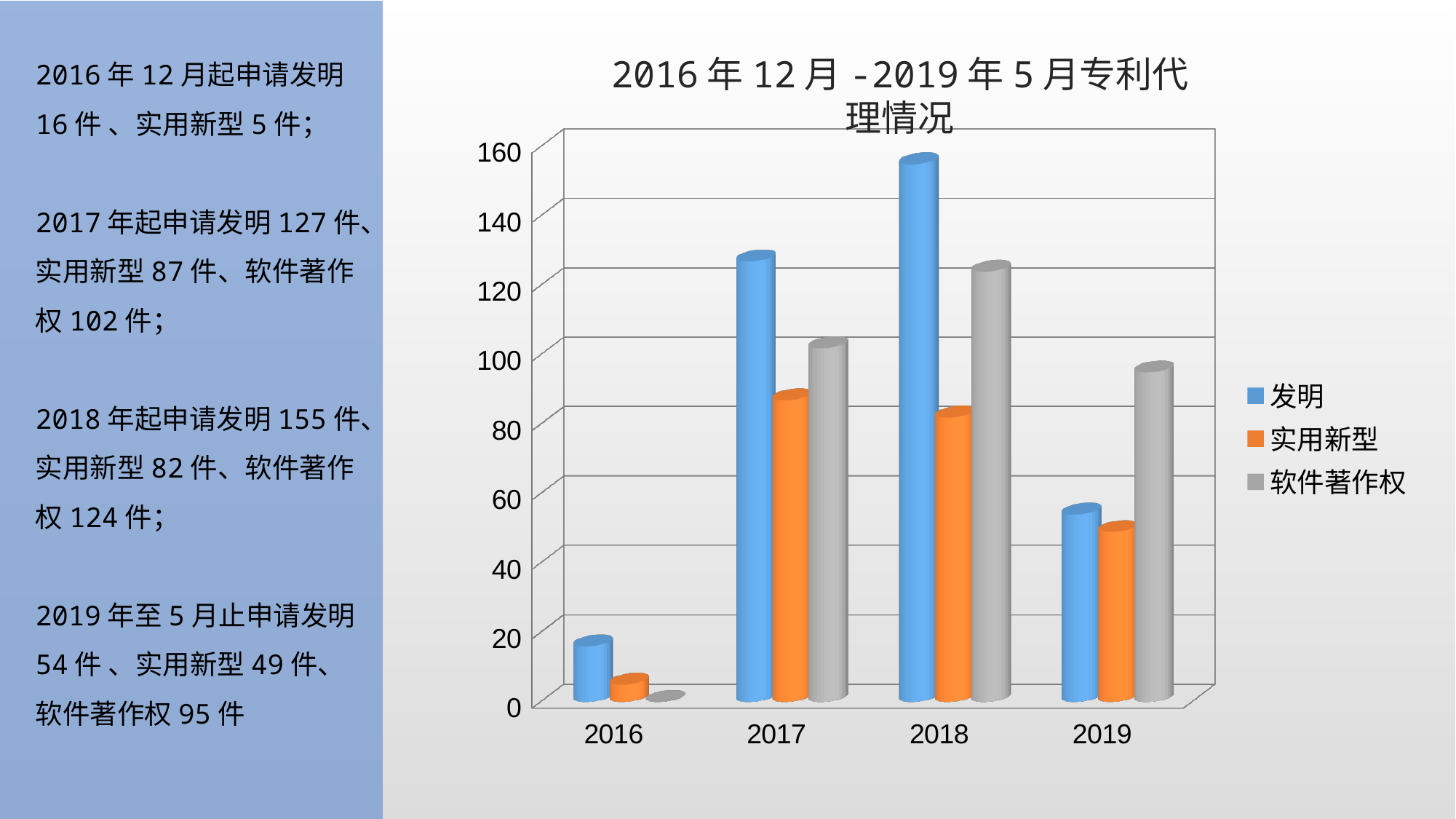
In 2019, which is larger: 软件著作权 or 实用新型? 软件著作权 How many series does the chart legend list? 3 What are the three series listed in the chart legend? 发明, 实用新型, 软件著作权 How many years are shown on the x axis of the chart? 4 Is the value for 发明 in 2018 greater or less than 140? greater Does the 发明 series rise or fall from 2016 to 2018? rise Is the value for 软件著作权 in 2019 greater or less than 80? greater In which year is the 发明 bar the lowest? 2016 In which year is the 发明 bar the highest? 2018 Is the value for 实用新型 in 2016 greater or less than 20? less What kind of chart is shown on the slide? Bar chart In 2017, which is larger: 发明 or 软件著作权? 发明